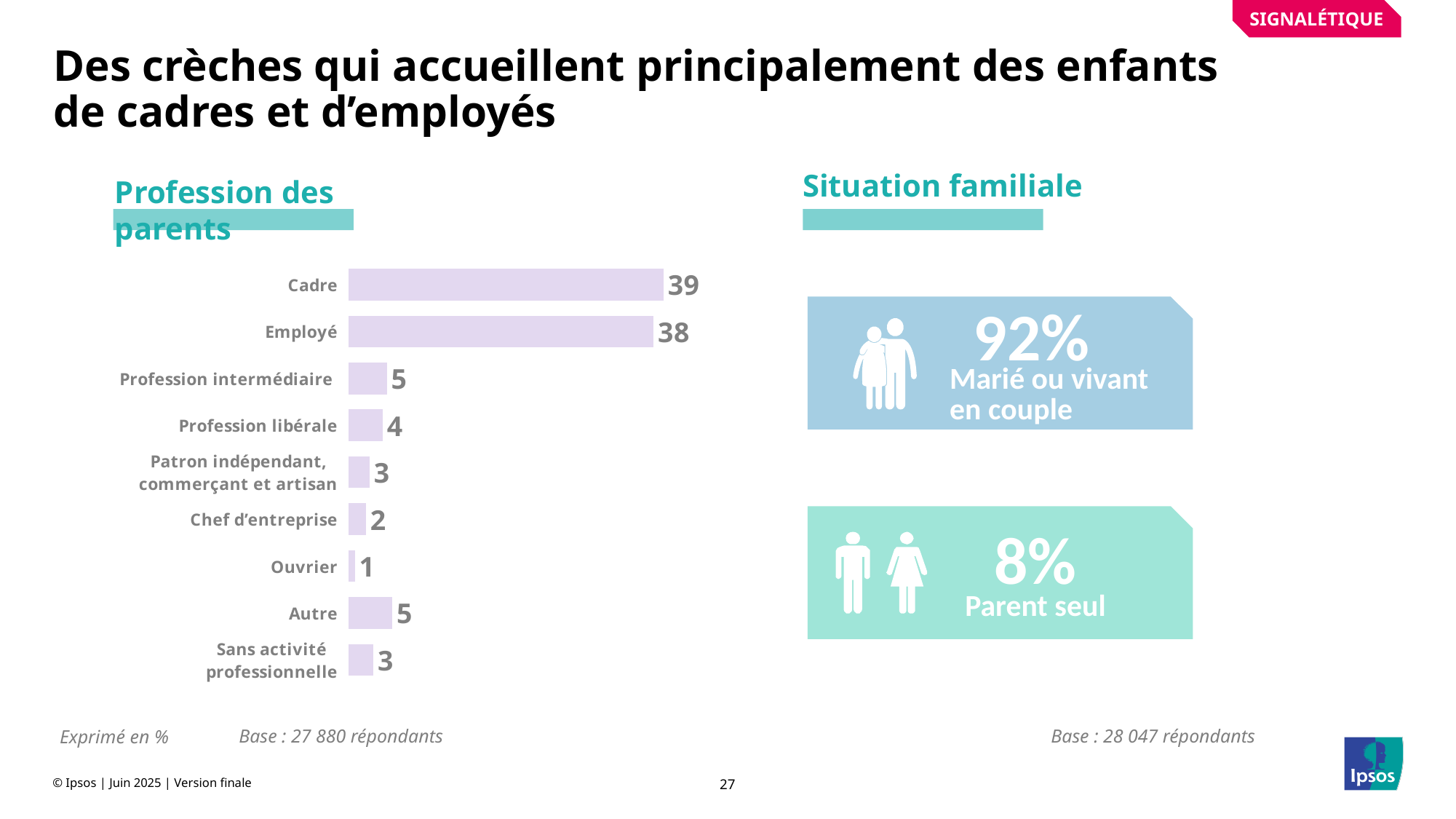
In the 'Profession des parents' chart, what is the difference between the values for Profession intermédiaire and Chef d'entreprise? 3 In the 'Profession des parents' chart, which category has the lowest value? Ouvrier In the 'Profession des parents' chart, what is the value for Cadre? 39 What type of chart is the 'Profession des parents' chart? Bar chart In the 'Profession des parents' chart, what is the value for Ouvrier? 1 In what unit are the values of the 'Profession des parents' chart expressed, according to the note below the chart? % How many categories are shown in the 'Profession des parents' chart? 9 In the 'Profession des parents' chart, what is the value for Employé? 38 In the 'Profession des parents' chart, which is larger: the value for Autre or the value for Sans activité professionnelle? Autre In the 'Profession des parents' chart, what is the value for Profession libérale? 4 In the 'Profession des parents' chart, which category has the highest value? Cadre In the 'Profession des parents' chart, what is the difference between the values for Cadre and Employé? 1